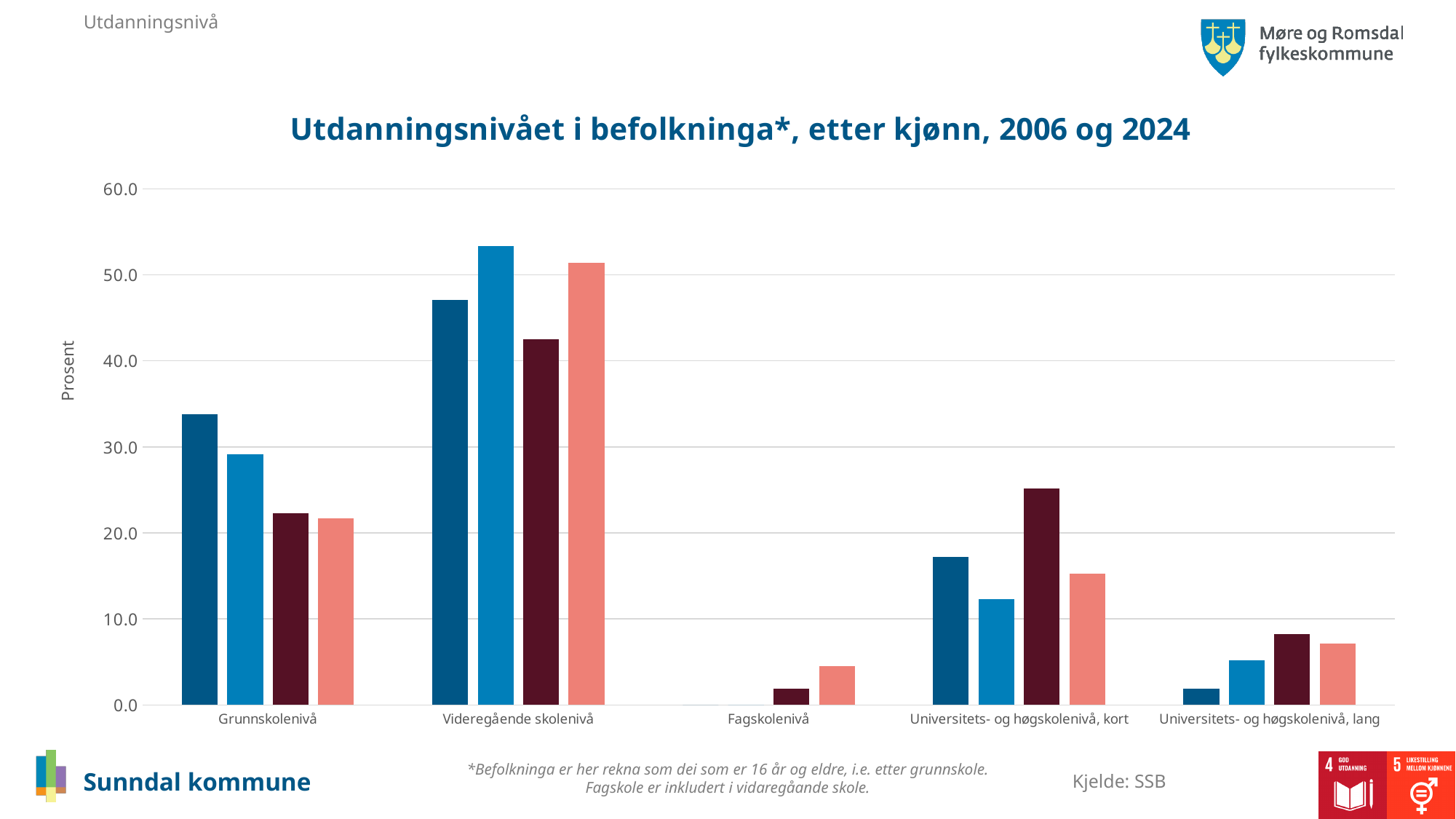
What kind of chart is shown on the slide? bar chart What is the title of the chart? Utdanningsnivået i befolkninga*, etter kjønn, 2006 og 2024 How many education-level categories are shown on the x axis? 5 Is the value of the dark maroon (third) bar for Universitets- og høgskolenivå, kort greater or less than 20.0? greater How many bars are plotted for the Grunnskolenivå category? 4 What is the label on the y axis of the chart? Prosent Is the value of the dark blue (first) bar for Grunnskolenivå greater or less than 30.0? greater Is the value of the light blue (second) bar for Videregående skolenivå greater or less than 50.0? greater For Grunnskolenivå, which is larger: the dark blue (first) bar or the light blue (second) bar? the dark blue (first) bar Which category has the lowest values overall in the chart? Fagskolenivå Which category has the tallest bars in the chart? Videregående skolenivå